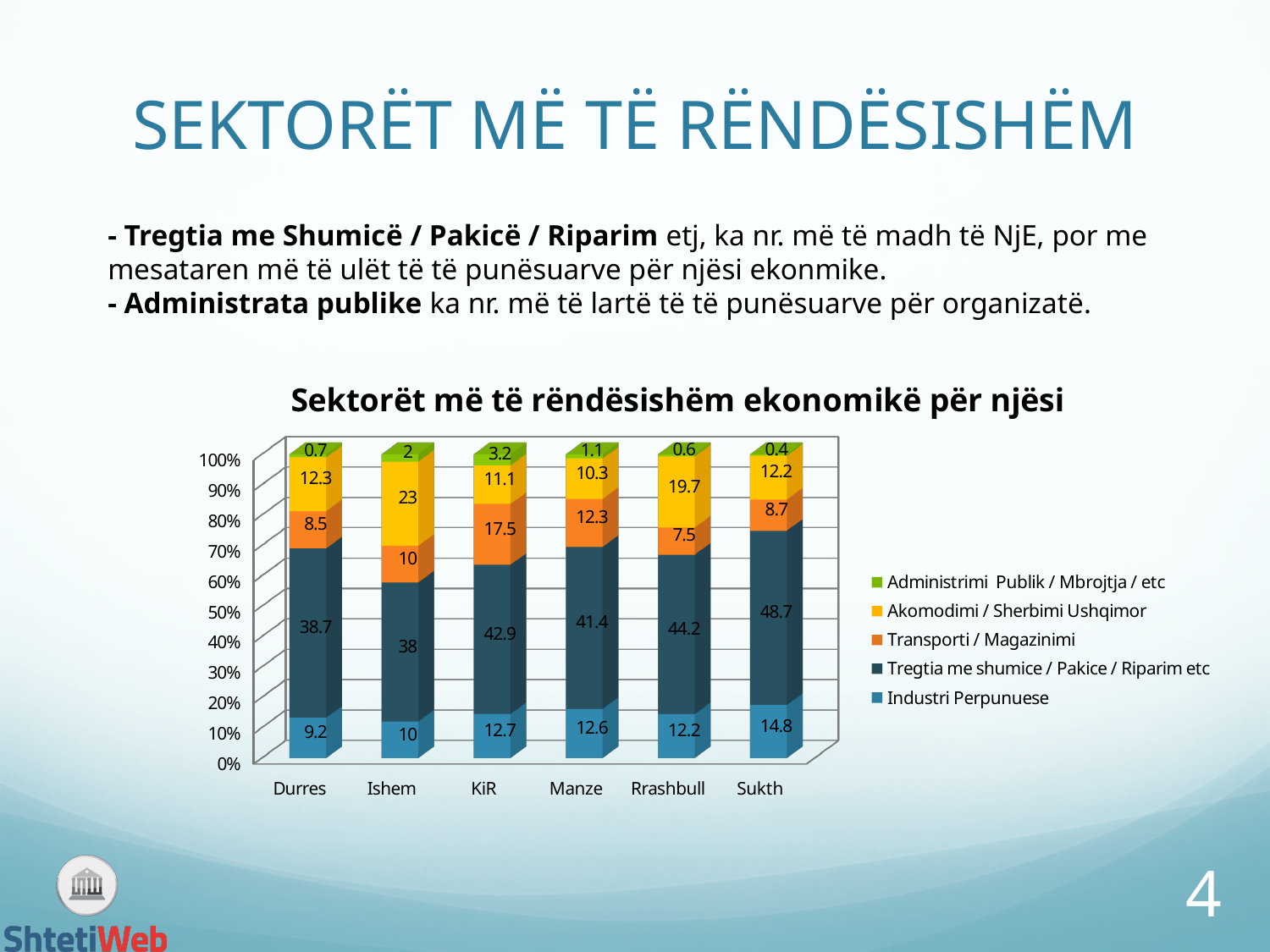
How many categories are shown on the x axis? 6 What is the title of the chart? Sektorët më të rëndësishëm ekonomikë për njësi Which is larger, the Akomodimi / Sherbimi Ushqimor value for Durres or for Manze? Durres What is the value for Tregtia me shumice / Pakice / Riparim etc in KiR? 42.9 What is the value for Administrimi Publik / Mbrojtja / etc in Rrashbull? 0.6 Which category has the highest value for Tregtia me shumice / Pakice / Riparim etc? Sukth How many series does the legend list? 5 What is the value for Industri Perpunuese in Sukth? 14.8 Which category has the lowest value for Industri Perpunuese? Durres What type of chart is shown on the slide? Stacked bar chart What is the value for Akomodimi / Sherbimi Ushqimor in Ishem? 23 What is the difference between the Transporti / Magazinimi values for KiR and Rrashbull? 10